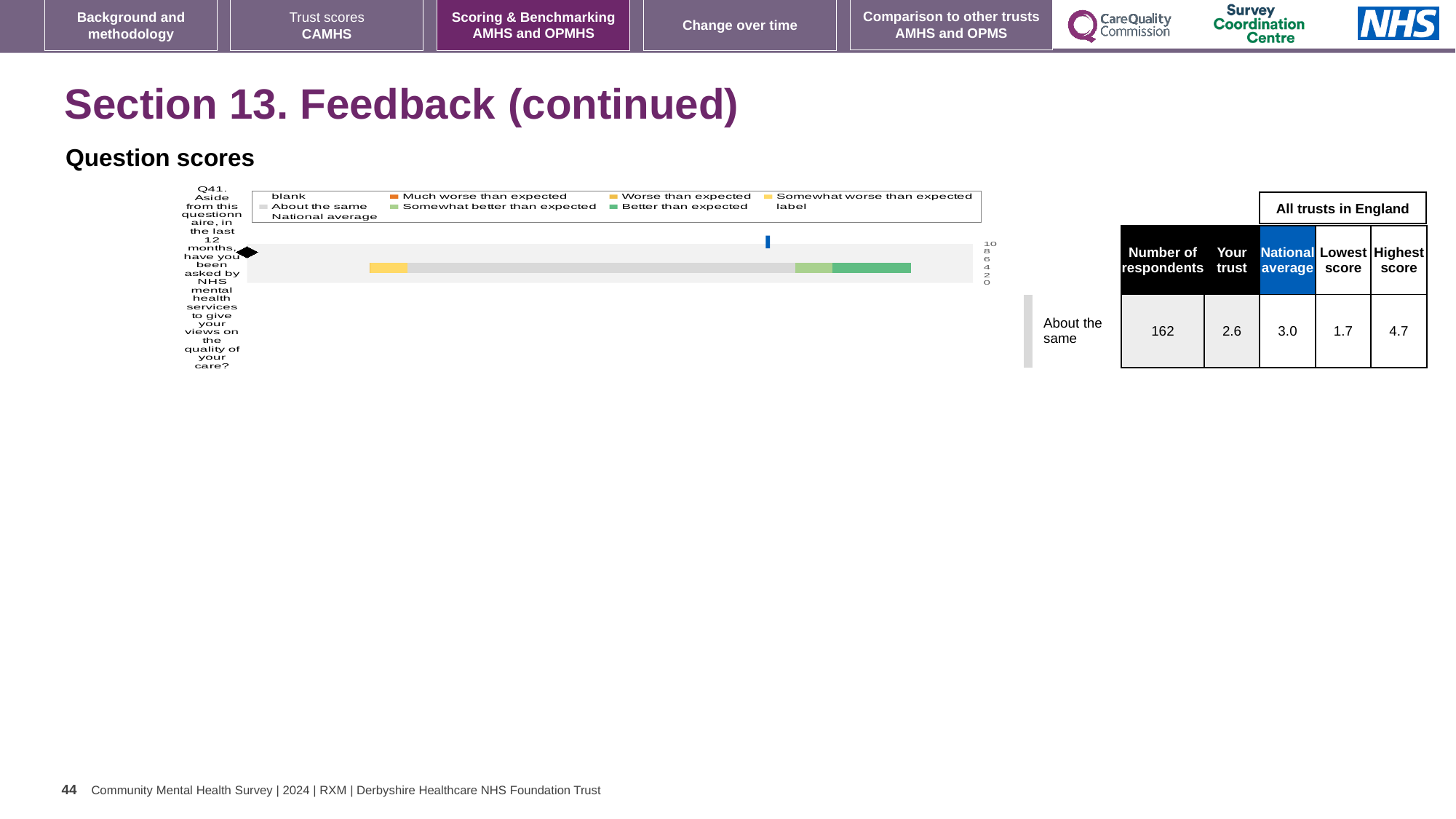
Which is larger for Q41: the trust's score or the national average? National average What is the 'Your trust' score for Q41 shown next to the chart? 2.6 What is the difference between the highest and lowest trust scores for Q41? 3.0 Which benchmarking category does the trust's Q41 score fall into? About the same What is the highest score among all trusts in England for Q41? 4.7 How many questions are plotted in the Question scores chart on this slide? 1 What kind of chart is used to show the Q41 question score on this slide? bar chart What is the heading above the Q41 chart on this slide? Question scores How many respondents answered Q41? 162 What is the lowest score among all trusts in England for Q41? 1.7 What is the national average score for Q41 shown next to the chart? 3.0 What is the difference between the national average and the trust's score for Q41? 0.4